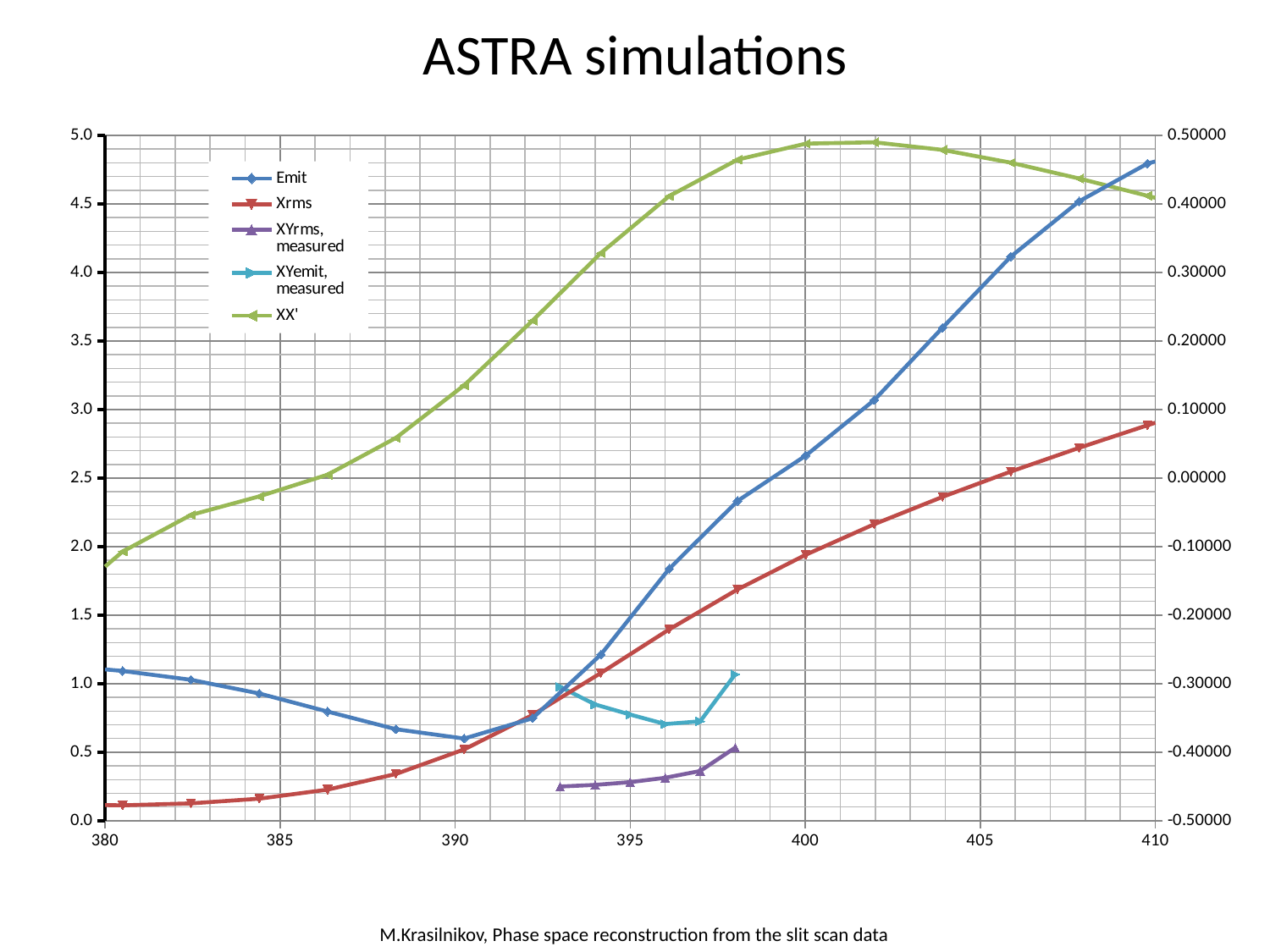
Does the Xrms series rise or fall as the x axis goes from 380 to 410? rises What is the title of the chart? ASTRA simulations What kind of chart is shown on the slide? line chart Does the XX' series rise or fall between x = 380 and x = 400? rises At which x value does the Emit series reach its lowest point? 390 Which series is drawn in green? XX' Is the value of the Emit series at x = 410 greater or less than 4.5? greater Is the value of the Xrms series at x = 380 greater or less than 0.5? less Is the value of the Emit series at x = 390 greater or less than 1.0? less At x = 405, which series has the larger value, Emit or Xrms? Emit How many series does the legend list? 5